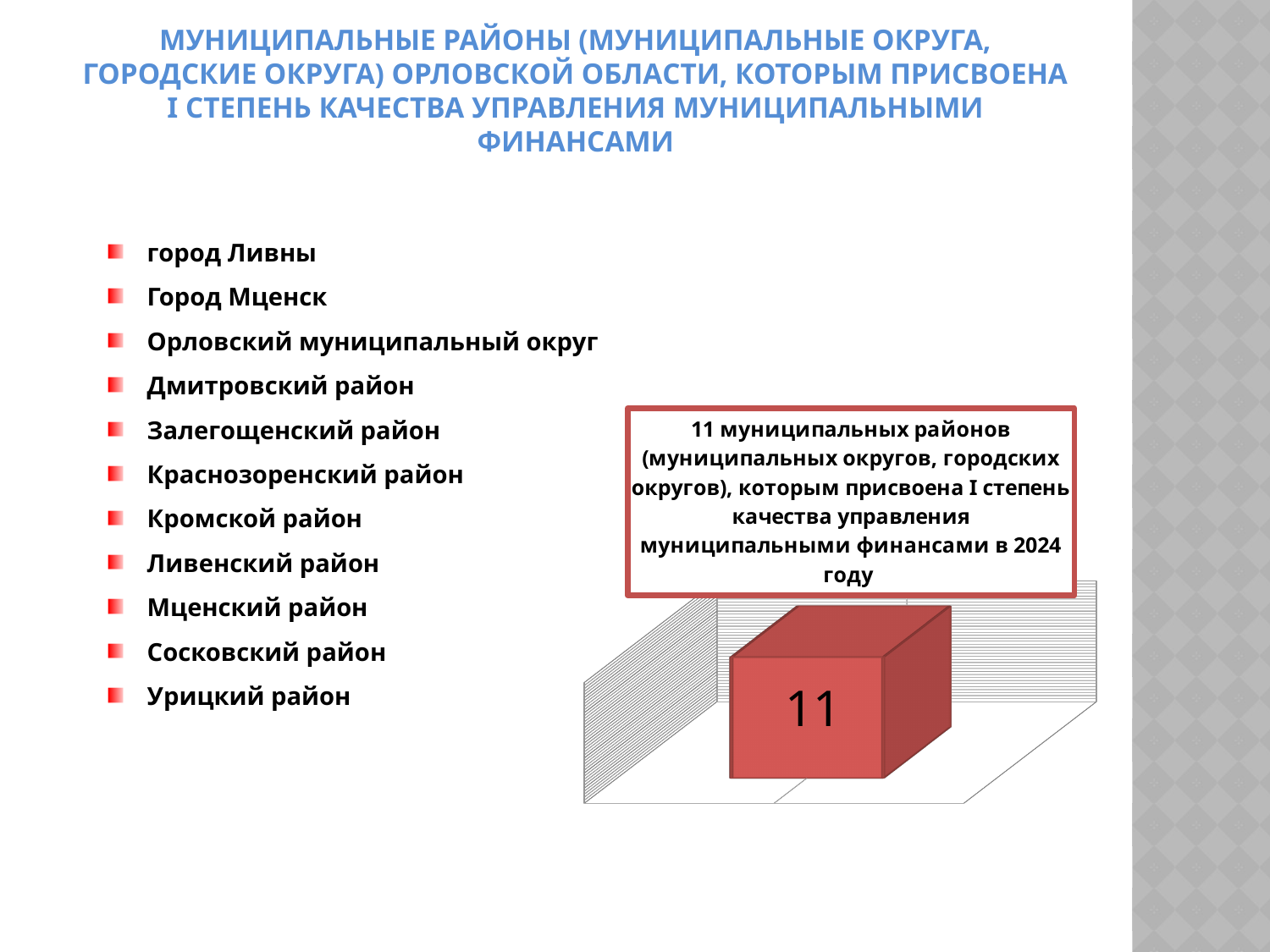
How many bars does the chart contain? 1 What value is printed on the bar in the chart? 11 According to the text box above the chart, for which year does the bar show the number of municipal districts with I degree of quality of municipal finance management? 2024 What colour is the bar in the chart? red What kind of chart is shown on the slide? bar chart